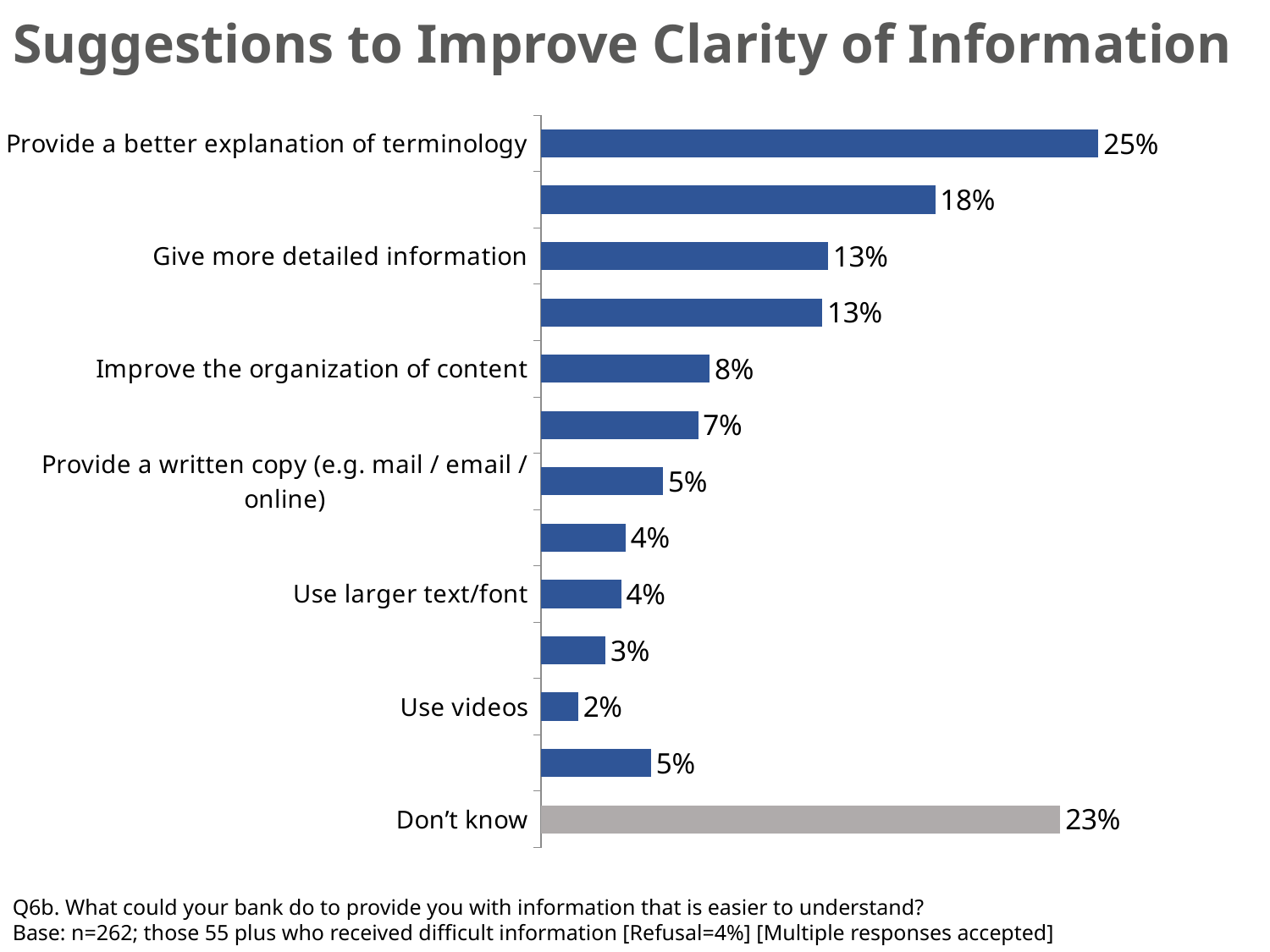
What is the difference in percentage points between "Provide a better explanation of terminology" and "Don't know"? 2 percentage points What is the value for "Give more detailed information"? 13% Which labelled suggestion has the lowest percentage? Use videos What percentage of respondents answered "Don't know"? 23% How many bars are plotted in the chart? 13 What colour is the "Don't know" bar, compared with the other bars? Grey (the others are blue) What percentage of respondents suggested providing a better explanation of terminology? 25% What type of chart is shown on the slide? Bar chart What is the value for "Use videos"? 2% Which is larger: the value for "Use larger text/font" or the value for "Provide a written copy (e.g. mail / email / online)"? Provide a written copy (e.g. mail / email / online) What is the value for "Improve the organization of content"? 8% Which suggestion has the highest percentage? Provide a better explanation of terminology